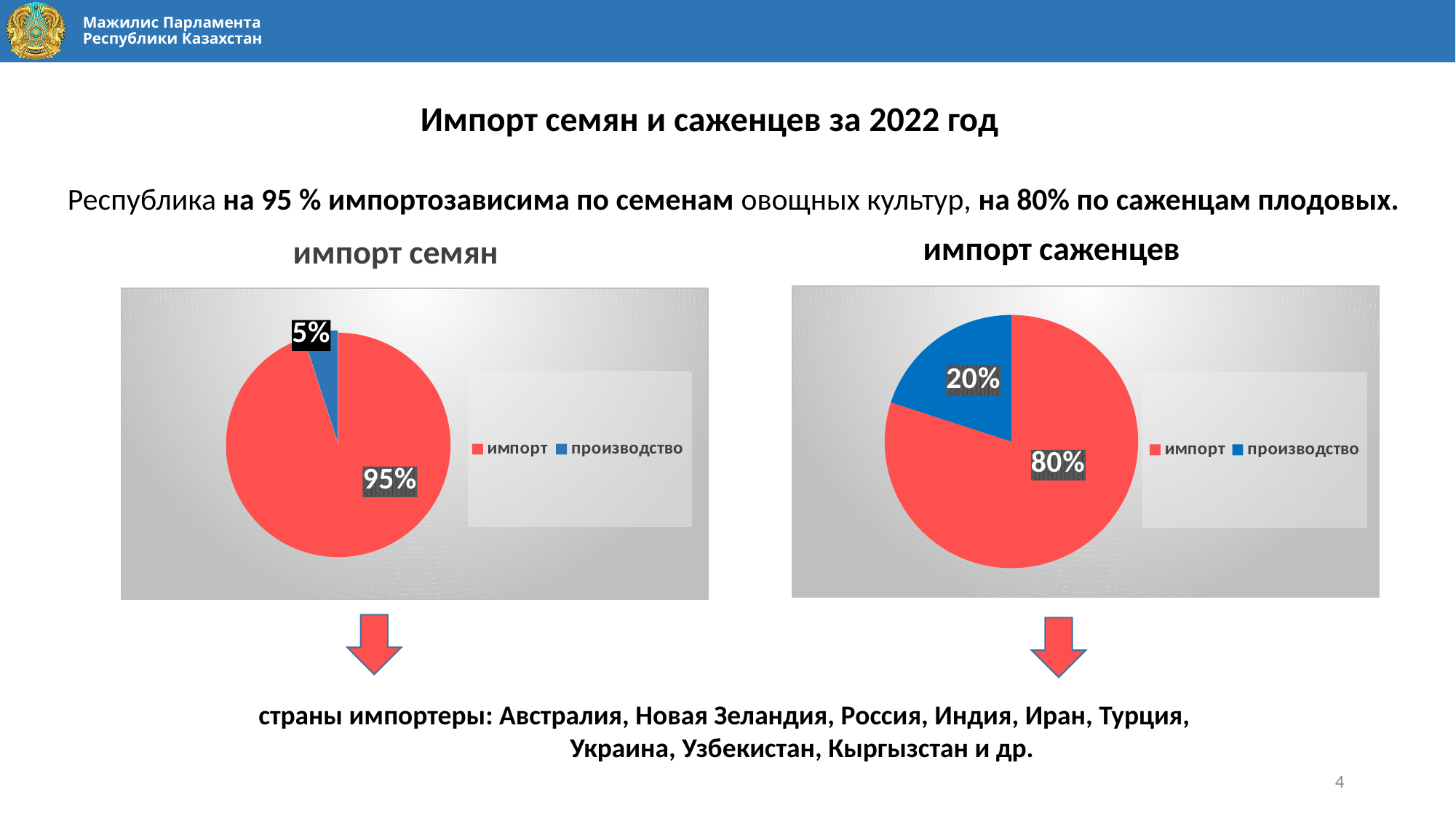
In the 'импорт саженцев' chart, what share does 'производство' have? 20% Which is larger: the 'производство' share in the 'импорт семян' chart or in the 'импорт саженцев' chart? импорт саженцев In the 'импорт саженцев' chart, what colour is the 'производство' slice? blue How many slices does the 'импорт саженцев' chart have? 2 In the 'импорт саженцев' chart, which slice is the smallest? производство In the 'импорт семян' chart, what share does 'импорт' have? 95% In the 'импорт саженцев' chart, what share does 'импорт' have? 80% How many series does the legend of the 'импорт семян' chart list? 2 In the 'импорт семян' chart, which slice is the largest? импорт What type of chart is the 'импорт семян' chart? pie chart In the 'импорт семян' chart, what share does 'производство' have? 5% In the 'импорт саженцев' chart, what is the difference between the 'импорт' and 'производство' shares? 60%